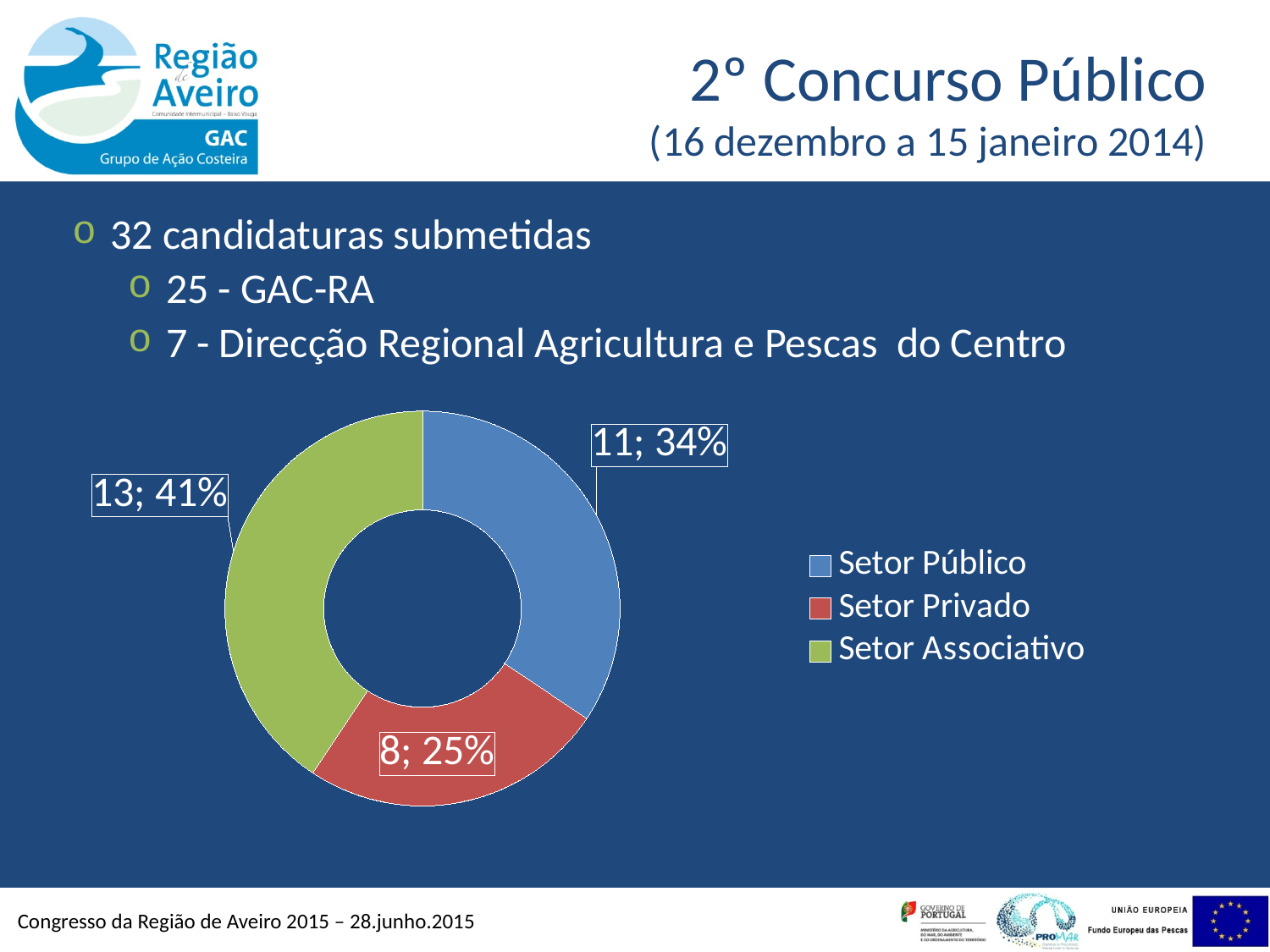
Which sector has the smallest slice in the doughnut chart? Setor Privado What is the value for Setor Associativo in the doughnut chart? 13 Which colour represents Setor Público in the doughnut chart? Blue What share of the doughnut chart does Setor Privado represent? 25% What is the difference between the values for Setor Associativo and Setor Privado in the doughnut chart? 5 What is the value for Setor Privado in the doughnut chart? 8 What kind of chart is shown on the slide? Doughnut chart How many entries does the legend of the doughnut chart list? 3 Which sector has the largest slice in the doughnut chart? Setor Associativo What share of the doughnut chart does Setor Associativo represent? 41% How many slices does the doughnut chart have? 3 What is the value for Setor Público in the doughnut chart? 11